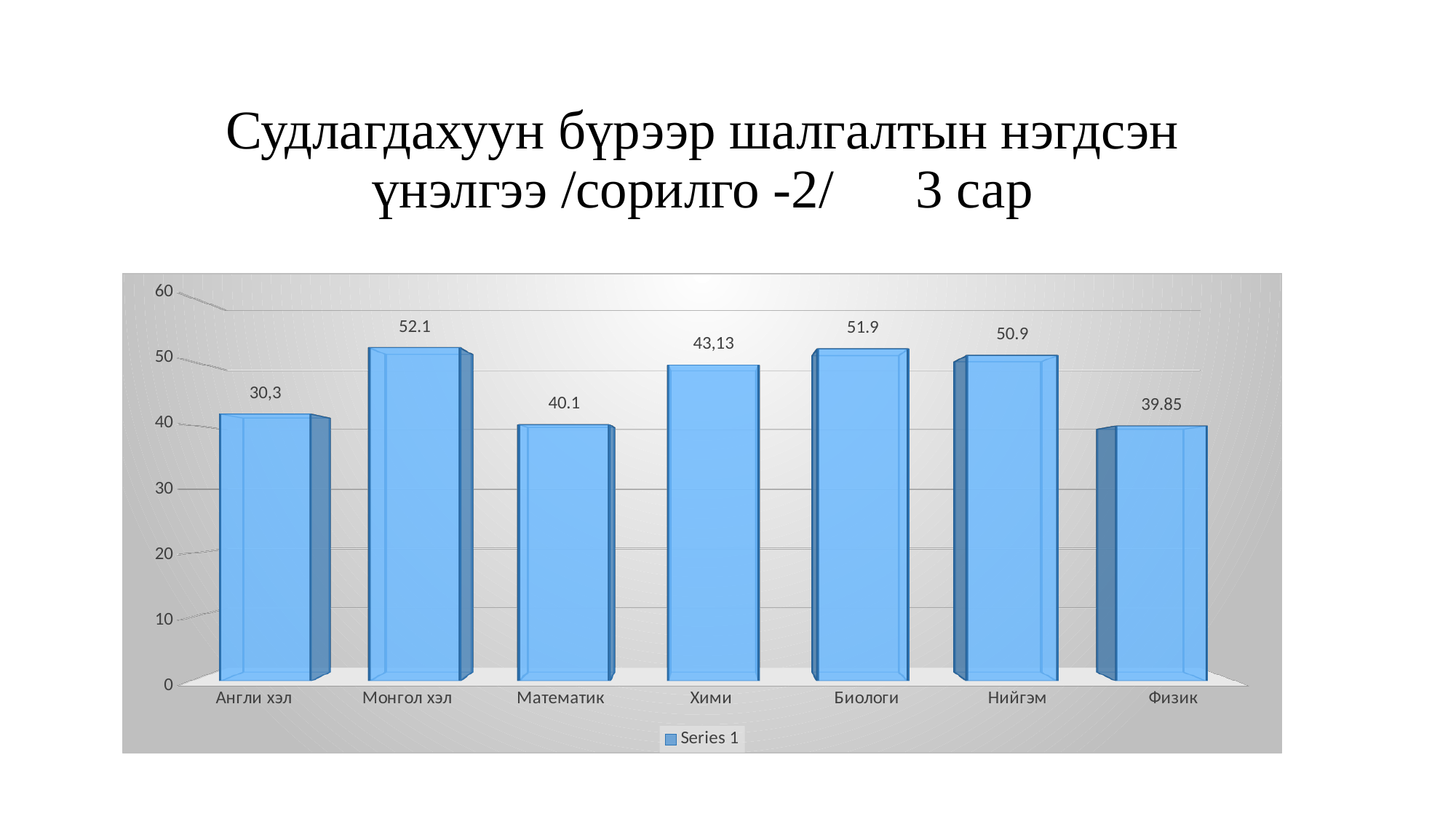
What value is shown for Монгол хэл? 52.1 What value is shown for Математик? 40.1 What is the difference between the values for Монгол хэл and Математик? 12.0 How many series does the legend list? 1 Is the value for Биологи greater or less than 50? greater What is the difference between the values for Биологи and Нийгэм? 1.0 Which category has the highest value? Монгол хэл What kind of chart is shown on the slide? bar chart How many categories are shown on the x axis? 7 What value is shown for Биологи? 51.9 What value is shown for Физик? 39.85 Which is larger, the value for Нийгэм or the value for Физик? Нийгэм